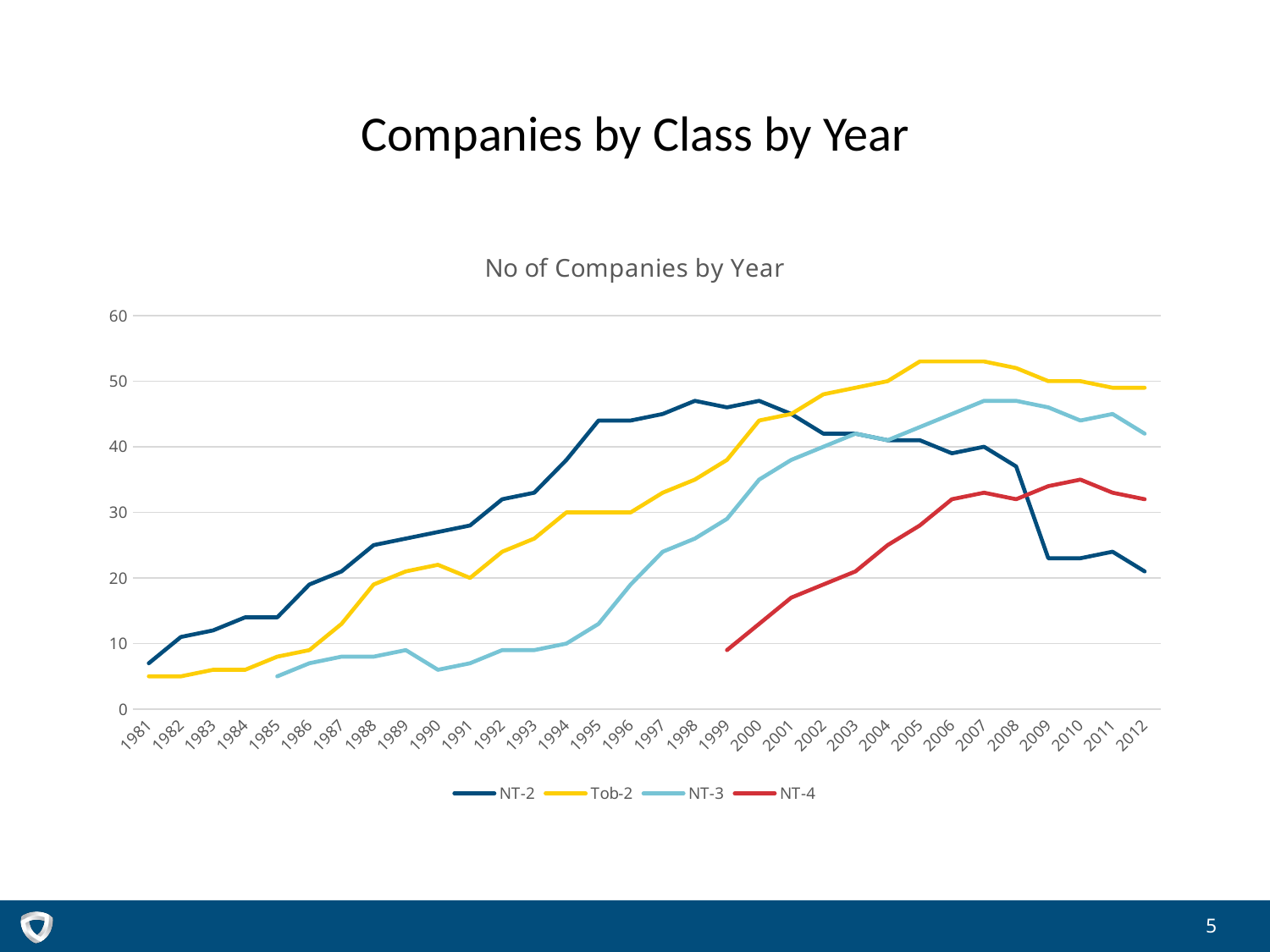
How many series does the legend list? 4 Does the NT-2 series rise or fall from 2000 to 2012? fall How many years are shown on the x axis? 32 Which series has the lowest value in 2012? NT-2 Is the value for NT-3 in 1990 greater or less than 10? less What kind of chart is shown on the slide? line chart Which series has the highest value in 2012? Tob-2 Is the value for NT-2 in 2009 greater or less than 30? less Is the value for NT-2 in 1998 greater or less than 40? greater In 1995, which is larger, NT-2 or Tob-2? NT-2